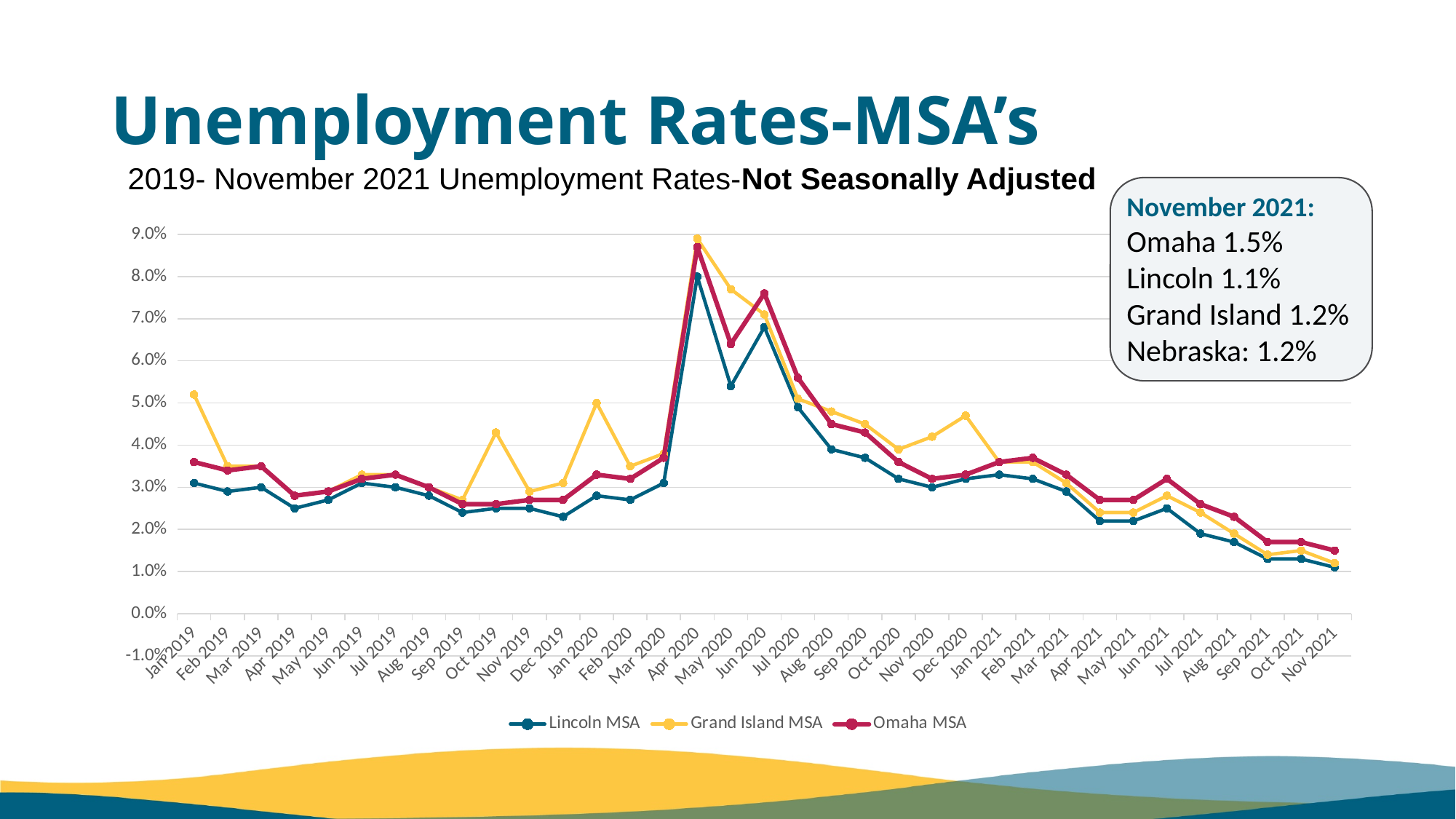
What is the difference between the Omaha and Lincoln unemployment rates in November 2021? 0.4% What is the unemployment rate for Grand Island MSA in November 2021? 1.2% Which MSA has the lowest unemployment rate in November 2021? Lincoln MSA Is the value for Lincoln MSA in Apr 2020 greater or less than 7.0%? greater What kind of chart is shown on the slide? line chart Is the value for Lincoln MSA in May 2020 greater or less than 6.0%? less Which MSA has the highest unemployment rate in November 2021? Omaha MSA What is the unemployment rate for Lincoln MSA in November 2021? 1.1% What is the unemployment rate for Omaha MSA in November 2021? 1.5% How many series does the chart's legend list? 3 In which month does the Grand Island MSA line reach its highest value? Apr 2020 Do the unemployment rates rise or fall from Jun 2020 to Nov 2021? fall